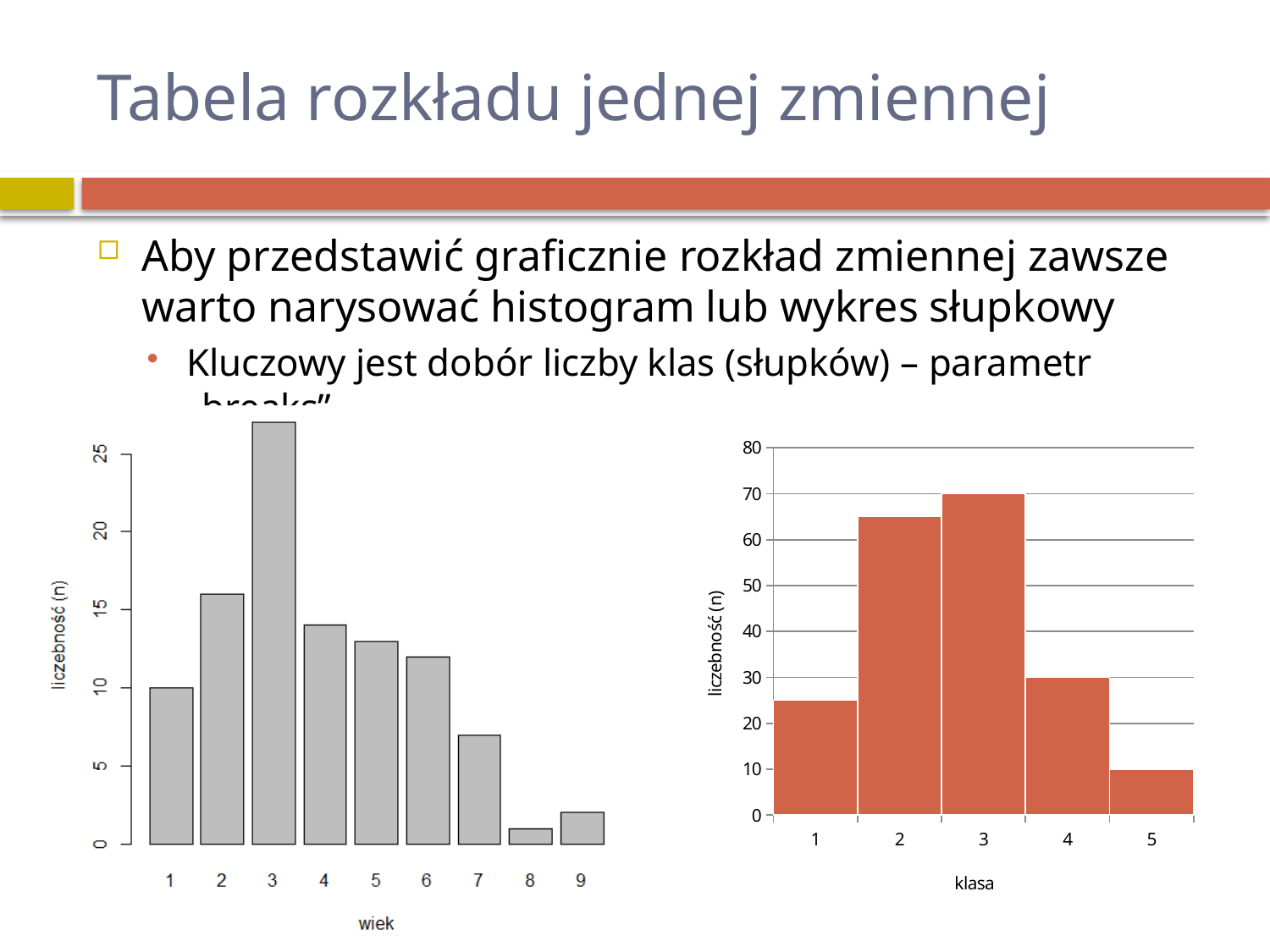
In the chart on the right (x axis 'klasa'), is the value for klasa 2 greater or less than 60? greater In the chart on the right (x axis 'klasa'), which klasa has the lowest liczebność? 5 In the chart on the right (x axis 'klasa'), what is the liczebność for klasa 5? 10 In the chart on the left (x axis 'wiek'), how many bars are shown? 9 In the chart on the left (x axis 'wiek'), which wiek has the highest liczebność? 3 In the chart on the right (x axis 'klasa'), how many categories are shown on the x axis? 5 In the chart on the left (x axis 'wiek'), is the value for wiek 3 greater or less than 25? greater What kind of chart is the chart on the right of the slide (x axis 'klasa')? bar chart In the chart on the right (x axis 'klasa'), which is larger, the value for klasa 1 or the value for klasa 4? klasa 4 In the chart on the right (x axis 'klasa'), what is the liczebność for klasa 3? 70 In the chart on the right (x axis 'klasa'), which klasa has the highest liczebność? 3 In the chart on the left (x axis 'wiek'), which is larger, the value for wiek 2 or the value for wiek 7? wiek 2